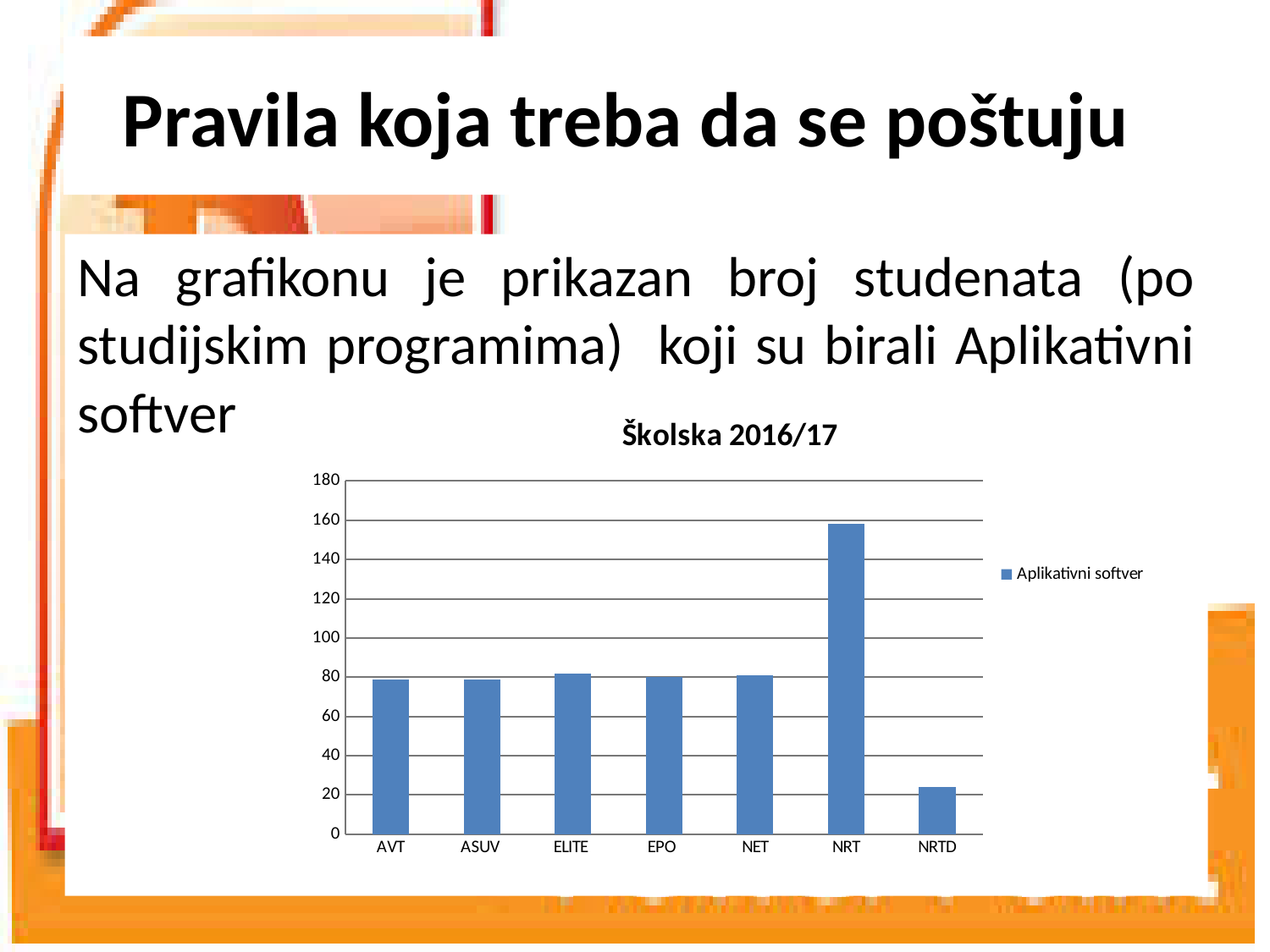
Is the value for EPO greater or less than 60? greater Which category has the lowest value? NRTD Is the value for NRTD greater or less than 40? less How many series does the legend list? 1 What is the title of the chart? Školska 2016/17 Which category has the highest value? NRT How many categories are shown on the x axis? 7 Is the value for NRT greater or less than 140? greater Which is larger, the value for NRT or the value for NET? NRT What kind of chart is shown on the slide? bar chart What is the name of the series shown in the legend? Aplikativni softver